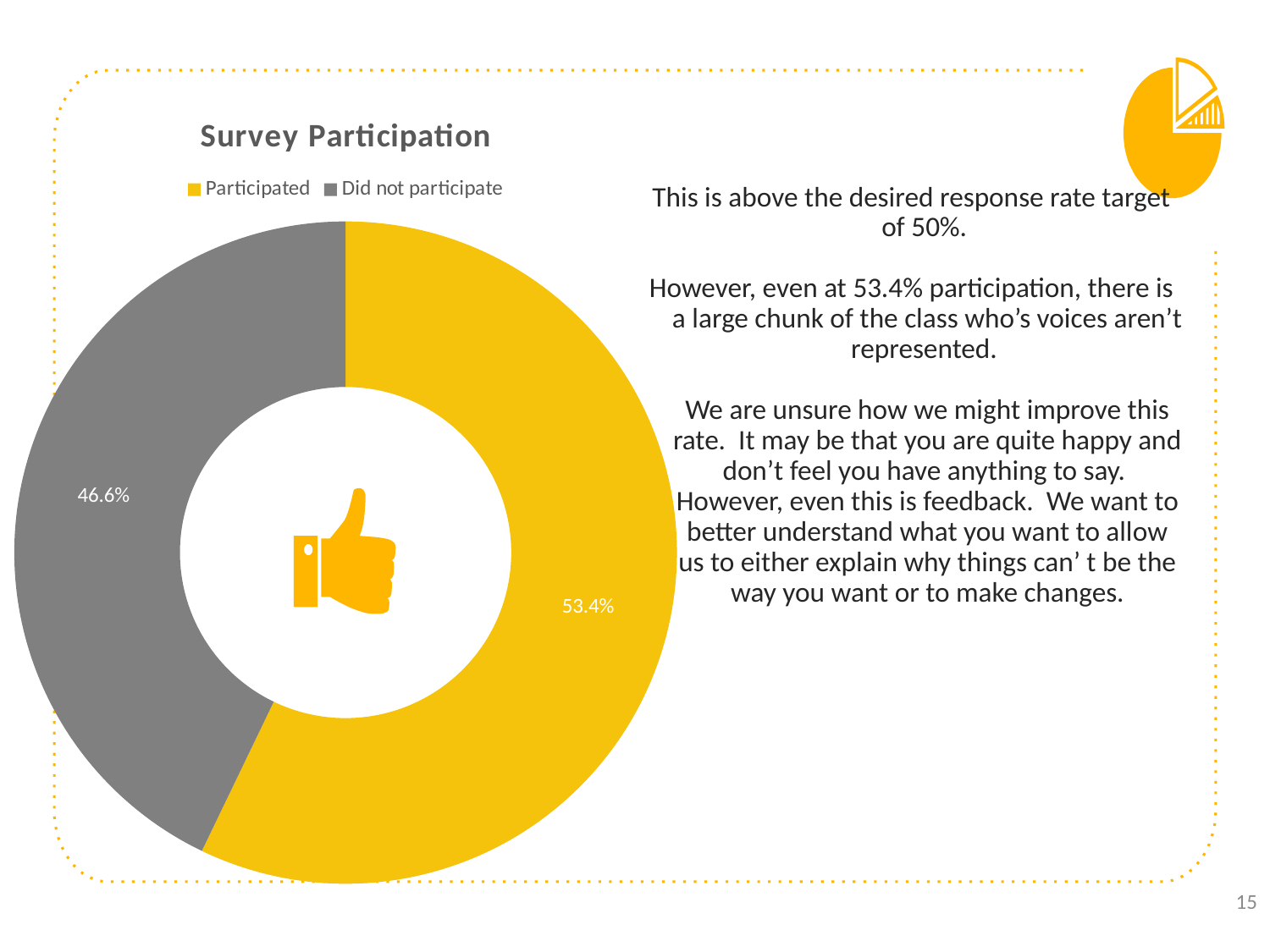
Which category has the larger share of the pie chart? Participated What is the difference in percentage points between the Participated and Did not participate slices? 6.8 How many entries does the chart legend list? 2 What colour is the Participated slice of the pie chart? yellow What kind of chart is shown on the slide? doughnut chart What percentage of the pie chart is labelled Did not participate? 46.6% Which category has the smaller share of the pie chart? Did not participate What is the title of the chart? Survey Participation Is the Participated slice larger or smaller than the Did not participate slice? larger What percentage of the pie chart is labelled Participated? 53.4% What share of the pie does the Did not participate slice represent? 46.6% How many slices does the pie chart have? 2